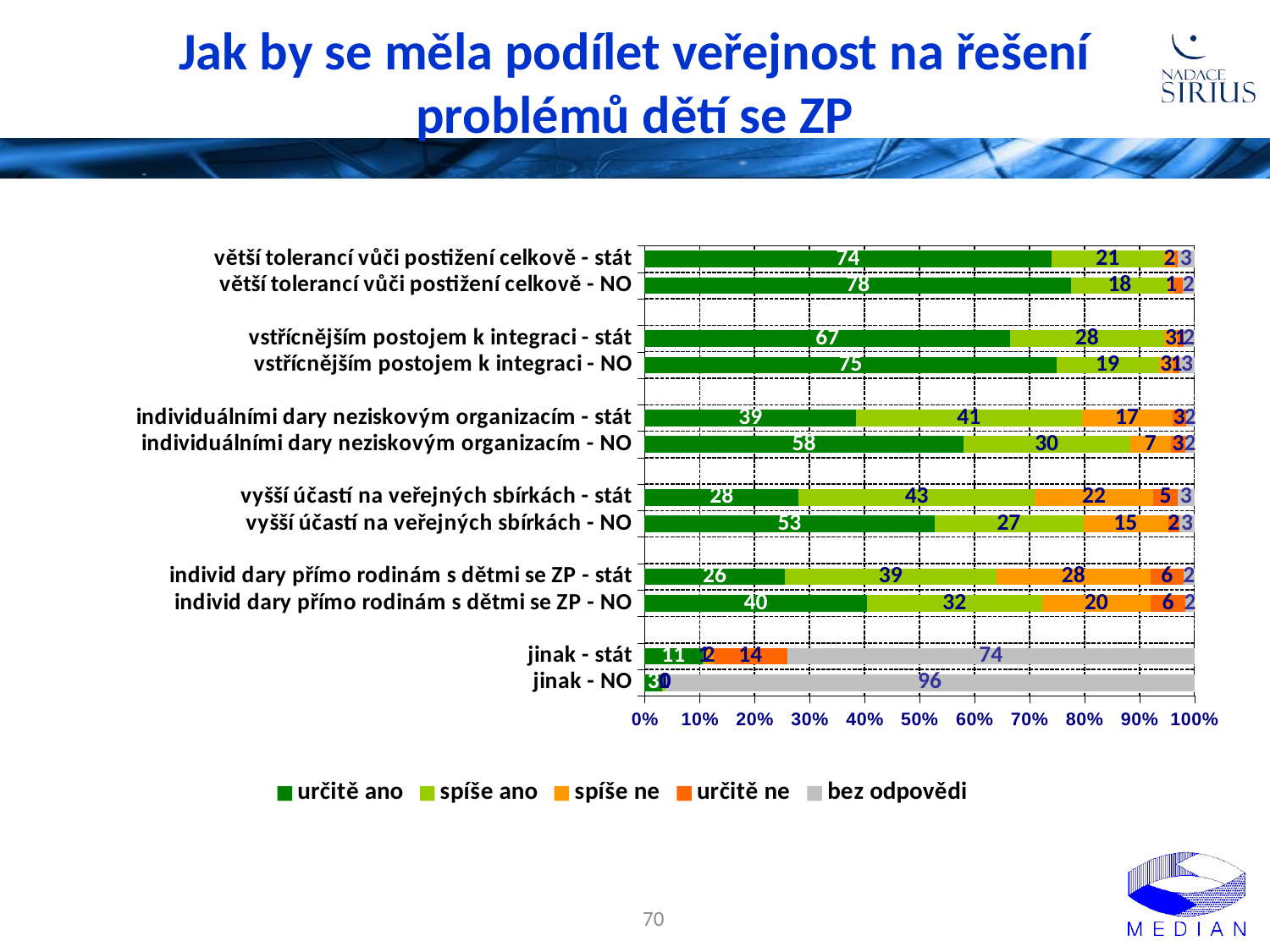
What is the 'určitě ano' value for 'větší tolerancí vůči postižení celkově - NO'? 78 What kind of chart is shown on the slide? stacked bar chart Which category has the lowest 'určitě ano' value? jinak - NO What is the 'spíše ne' value for 'individ dary přímo rodinám s dětmi se ZP - stát'? 28 Which legend entry is shown in grey? bez odpovědi What is the 'spíše ano' value for 'individuálními dary neziskovým organizacím - stát'? 41 What is the difference between the 'určitě ano' values for 'větší tolerancí vůči postižení celkově - NO' and 'větší tolerancí vůči postižení celkově - stát'? 4 What is the 'bez odpovědi' value for 'jinak - NO'? 96 Which category has the highest 'určitě ano' value? větší tolerancí vůči postižení celkově - NO Which has the larger 'určitě ano' value: 'vstřícnějším postojem k integraci - stát' or 'vstřícnějším postojem k integraci - NO'? vstřícnějším postojem k integraci - NO How many categories (bars) are plotted on the chart? 14 How many series does the legend list? 5